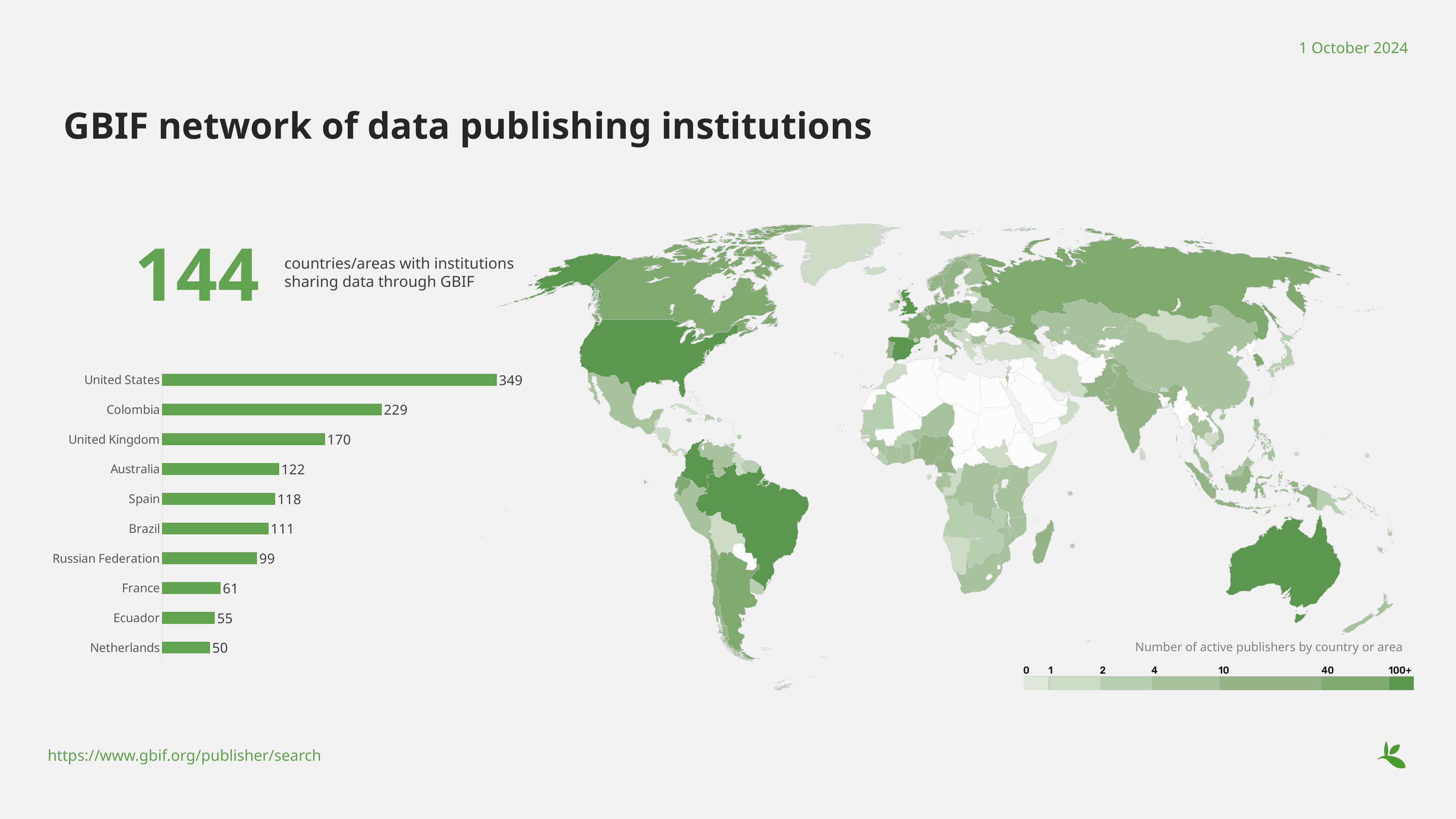
In the bar chart, what is the value for Colombia? 229 What kind of chart is shown on the left of the slide? Bar chart In the bar chart, which country has the lowest value? Netherlands In the bar chart, how many active publishers does the United States have? 349 In the bar chart, which country has the highest value? United States In the bar chart, what is the difference between the values for Australia and Spain? 4 According to the map legend, what does the colour scale on the map represent? Number of active publishers by country or area What is the highest value labelled on the map's colour scale? 100+ How many countries are shown in the bar chart? 10 In the bar chart, what is the difference between the values for the United States and Colombia? 120 In the bar chart, what is the value for the Russian Federation? 99 In the bar chart, which has a larger value, France or Ecuador? France